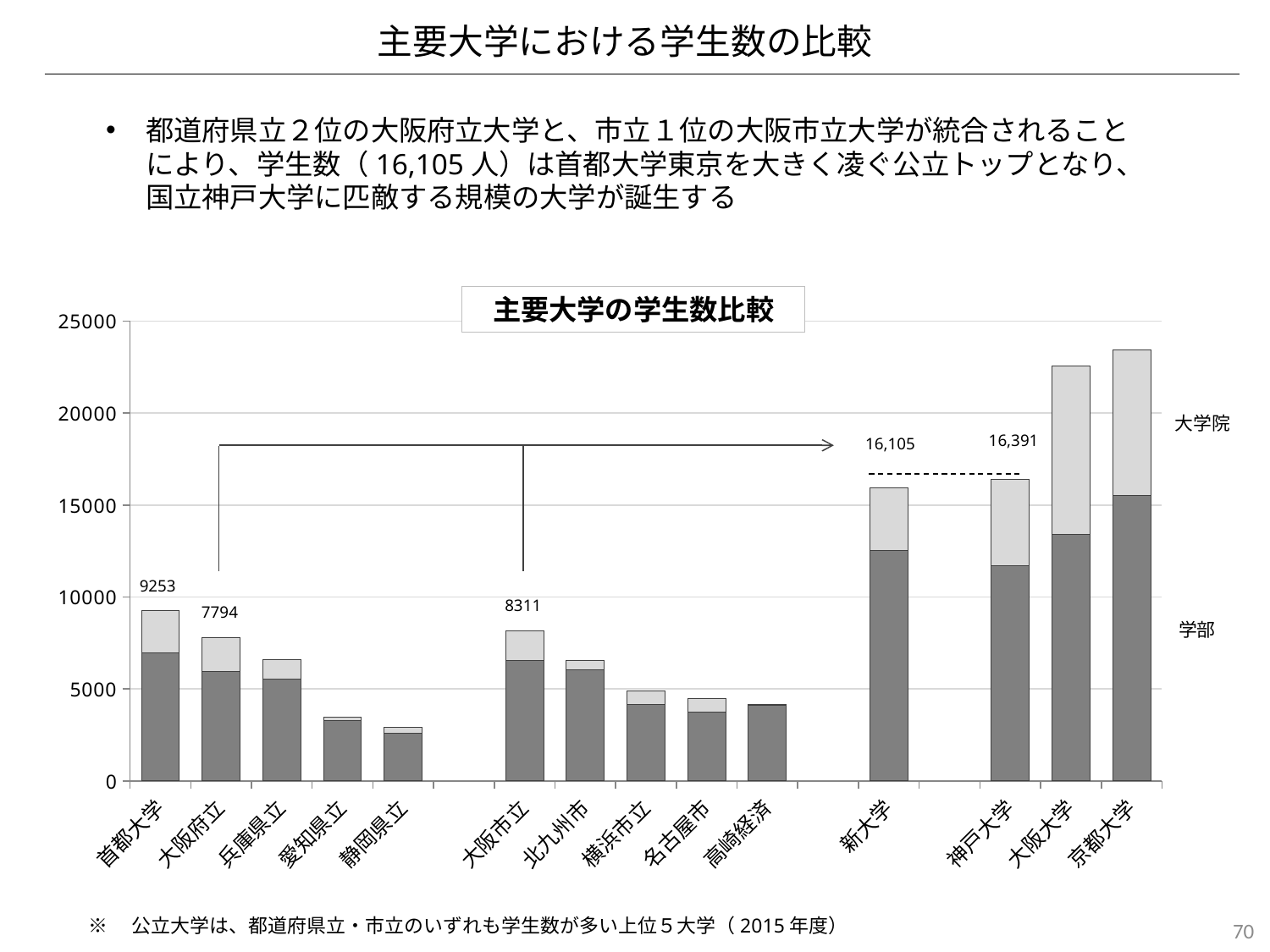
How many universities are shown on the x axis of the chart? 14 What is the difference between the labelled totals for 神戸大学 and 新大学? 286 What is the total number of students labelled for 神戸大学? 16,391 How many series does the chart show (学部 and 大学院)? 2 Which university has the highest total number of students in the chart? 京都大学 What is the difference between the labelled totals for 首都大学 and 大阪府立? 1459 What kind of chart is shown on the slide? Stacked bar chart What is the total number of students labelled for 新大学? 16,105 Is the total value for 大阪大学 greater or less than 20000? greater Which has a larger labelled total, 大阪市立 or 大阪府立? 大阪市立 Which university has the lowest total number of students in the chart? 静岡県立 What is the total number of students labelled for 首都大学? 9253